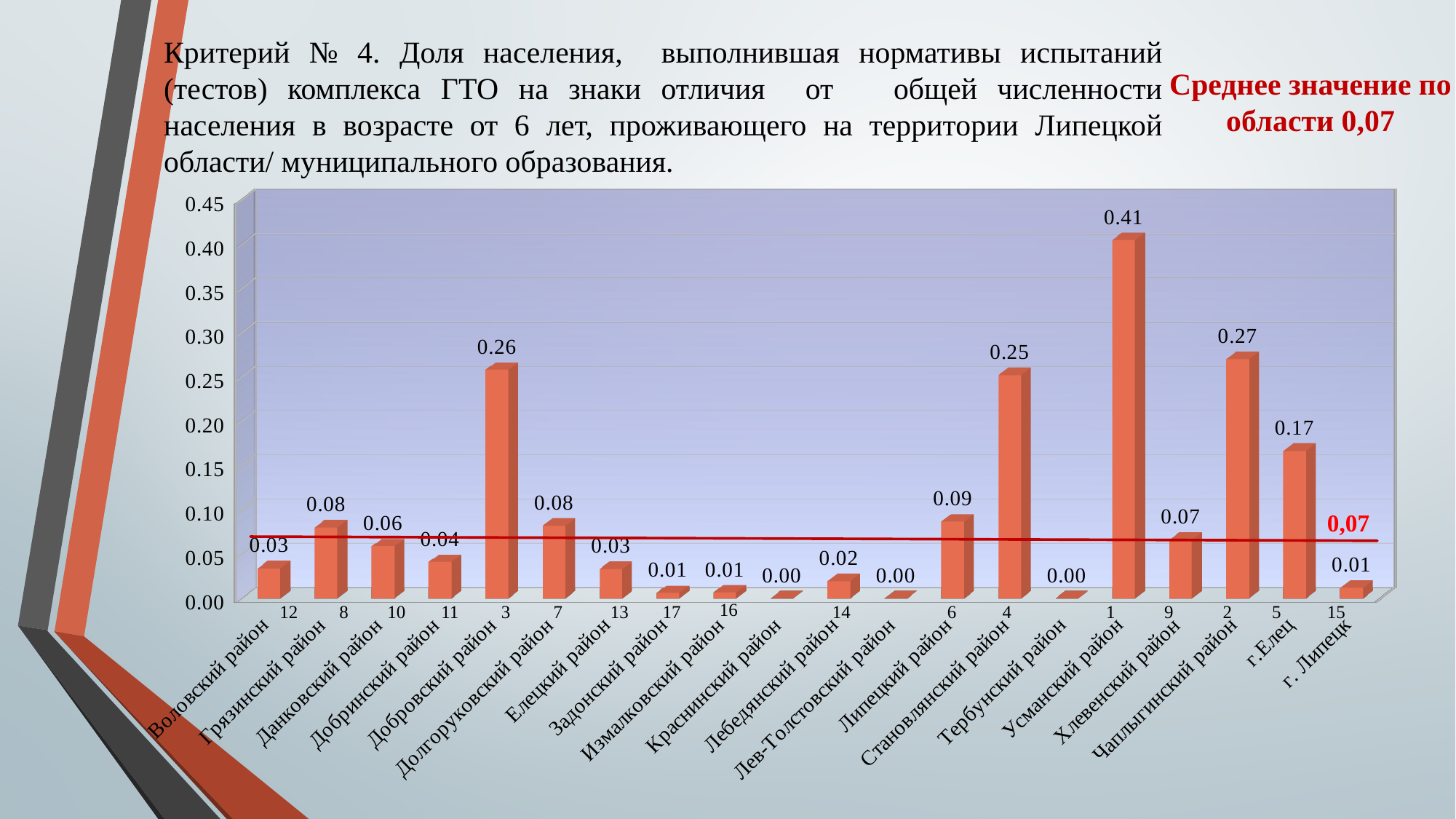
What is the difference between the values for Усманский район and Чаплыгинский район? 0.14 How many categories are shown on the x axis? 20 What kind of chart is shown on the slide? bar chart What is the value for Добровский район? 0.26 What is the value for Усманский район? 0.41 Which is larger, the value for Чаплыгинский район or the value for г.Елец? Чаплыгинский район What is the value for г.Елец? 0.17 What is the value for Хлевенский район? 0.07 What value does the red horizontal line across the chart represent? 0,07 Which category has the highest value? Усманский район What is the difference between the values for Добровский район and Становлянский район? 0.01 Which is larger, the value for Липецкий район or the value for Грязинский район? Липецкий район